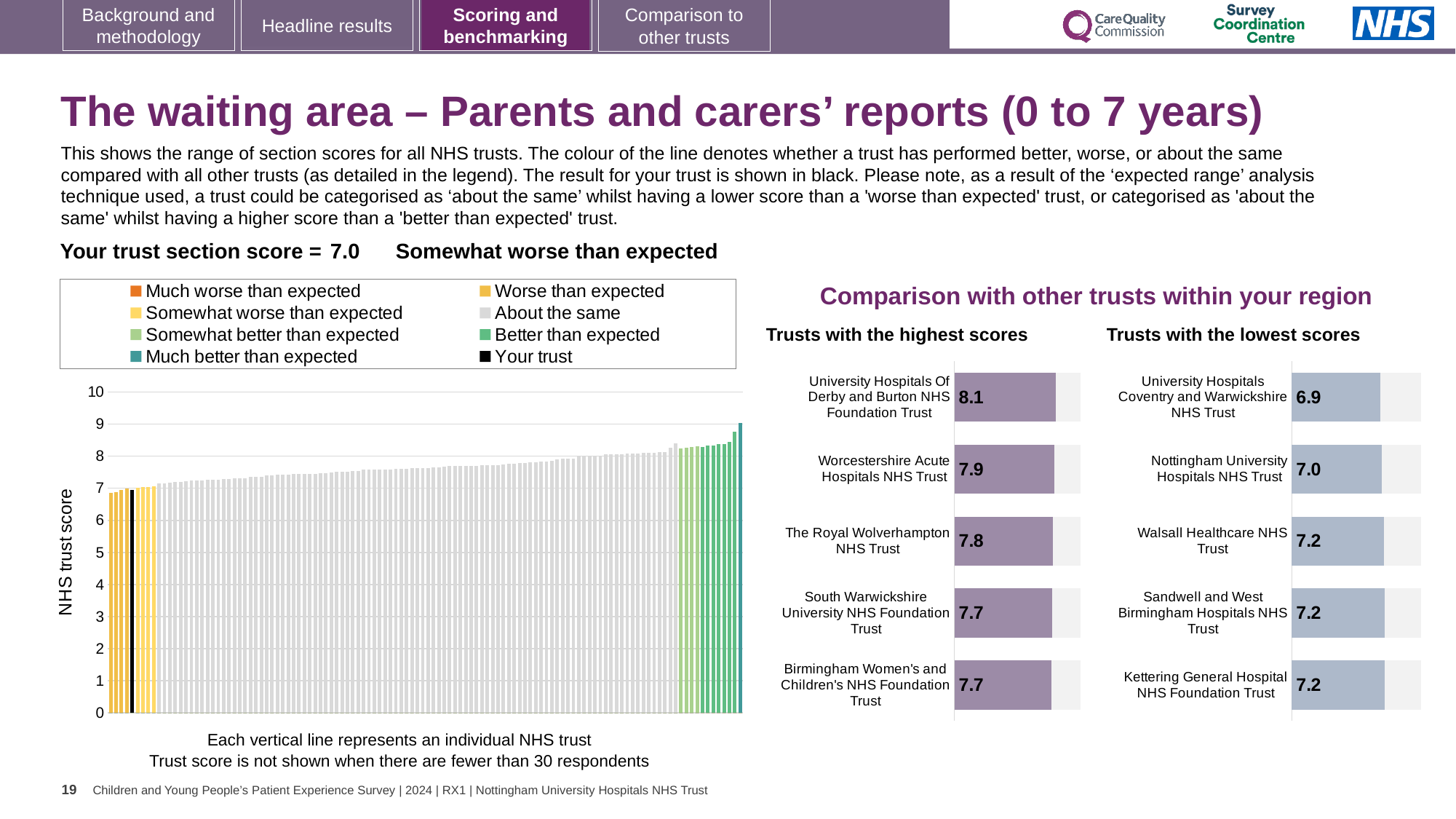
How many entries does the legend above the large chart on the left list? 8 In the 'Trusts with the lowest scores' chart, what is the score for University Hospitals Coventry and Warwickshire NHS Trust? 6.9 In the 'Trusts with the lowest scores' chart, which has the larger score: Nottingham University Hospitals NHS Trust or Walsall Healthcare NHS Trust? Walsall Healthcare NHS Trust In the 'Trusts with the lowest scores' chart, what is the score for Kettering General Hospital NHS Foundation Trust? 7.2 In the 'Trusts with the highest scores' chart, what is the score for University Hospitals Of Derby and Burton NHS Foundation Trust? 8.1 In the 'Trusts with the highest scores' chart, what is the difference between the scores of University Hospitals Of Derby and Burton NHS Foundation Trust and Worcestershire Acute Hospitals NHS Trust? 0.2 In the large chart on the left, is the value for 'Your trust' greater or less than 8? less In the 'Trusts with the lowest scores' chart, which trust has the lowest score? University Hospitals Coventry and Warwickshire NHS Trust What kind of chart is the large chart on the left showing NHS trust scores? Bar chart How many trusts are listed in the 'Trusts with the highest scores' chart? 5 In the 'Trusts with the highest scores' chart, what is the score for The Royal Wolverhampton NHS Trust? 7.8 In the 'Trusts with the highest scores' chart, which trust has the highest score? University Hospitals Of Derby and Burton NHS Foundation Trust